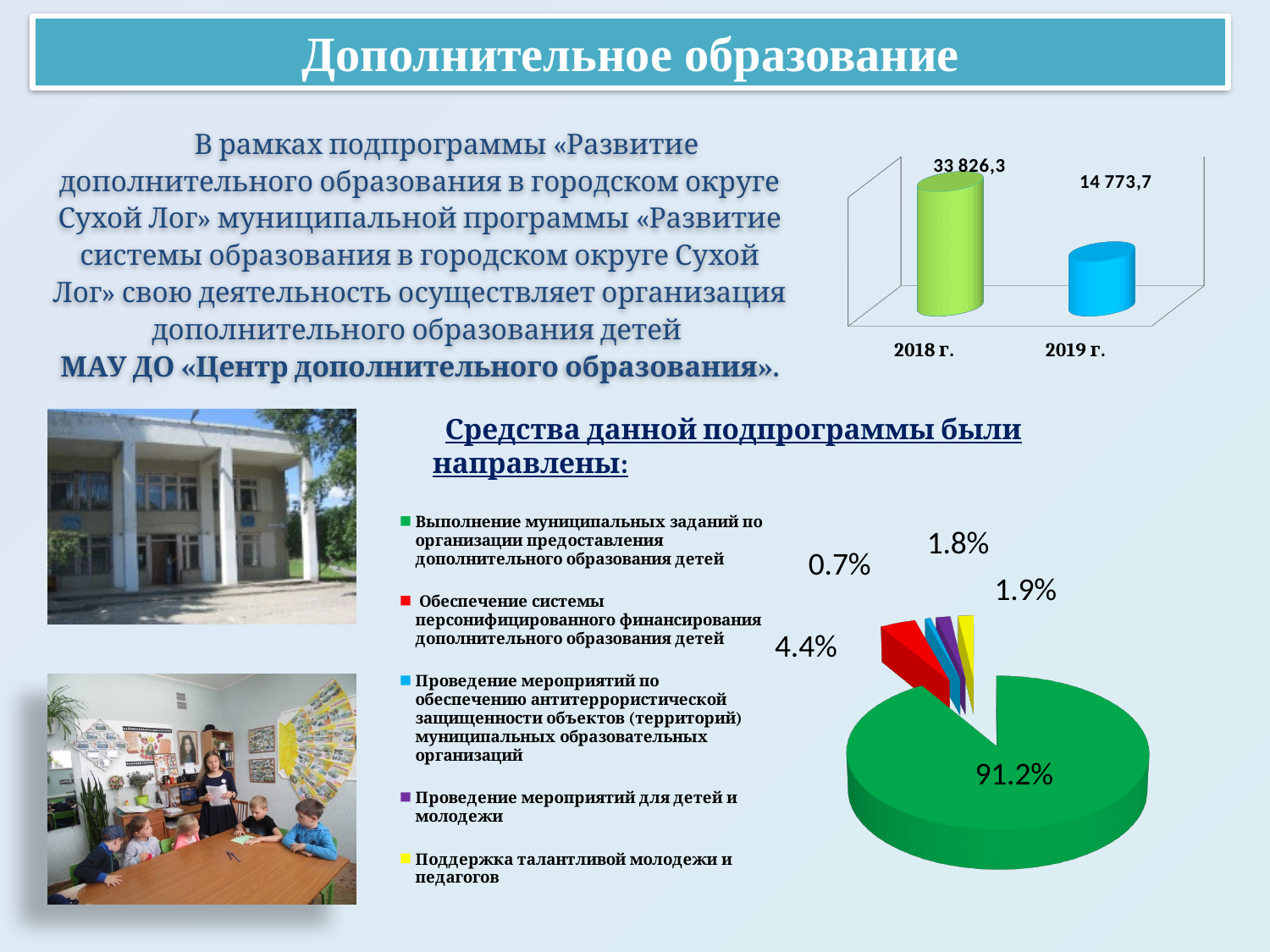
In the pie chart at the bottom right, what share goes to 'Выполнение муниципальных заданий по организации предоставления дополнительного образования детей'? 91.2% In the bar chart at the top right, what is the value for 2018 г.? 33 826,3 In the bar chart at the top right, what is the difference between the 2018 г. and 2019 г. values? 19 052,6 In the bar chart at the top right, does the value rise or fall from 2018 г. to 2019 г.? Fall In the pie chart at the bottom right, what is the share of the smallest slice? 0.7% In the pie chart at the bottom right, what is the share of the largest slice? 91.2% How many categories does the legend of the pie chart at the bottom right list? 5 How many bars are shown in the bar chart at the top right? 2 In the pie chart at the bottom right, what share goes to 'Обеспечение системы персонифицированного финансирования дополнительного образования детей'? 4.4% What kind of chart is shown at the top right of the slide? Bar chart In the bar chart at the top right, what is the value for 2019 г.? 14 773,7 In the bar chart at the top right, which year has the higher value? 2018 г.